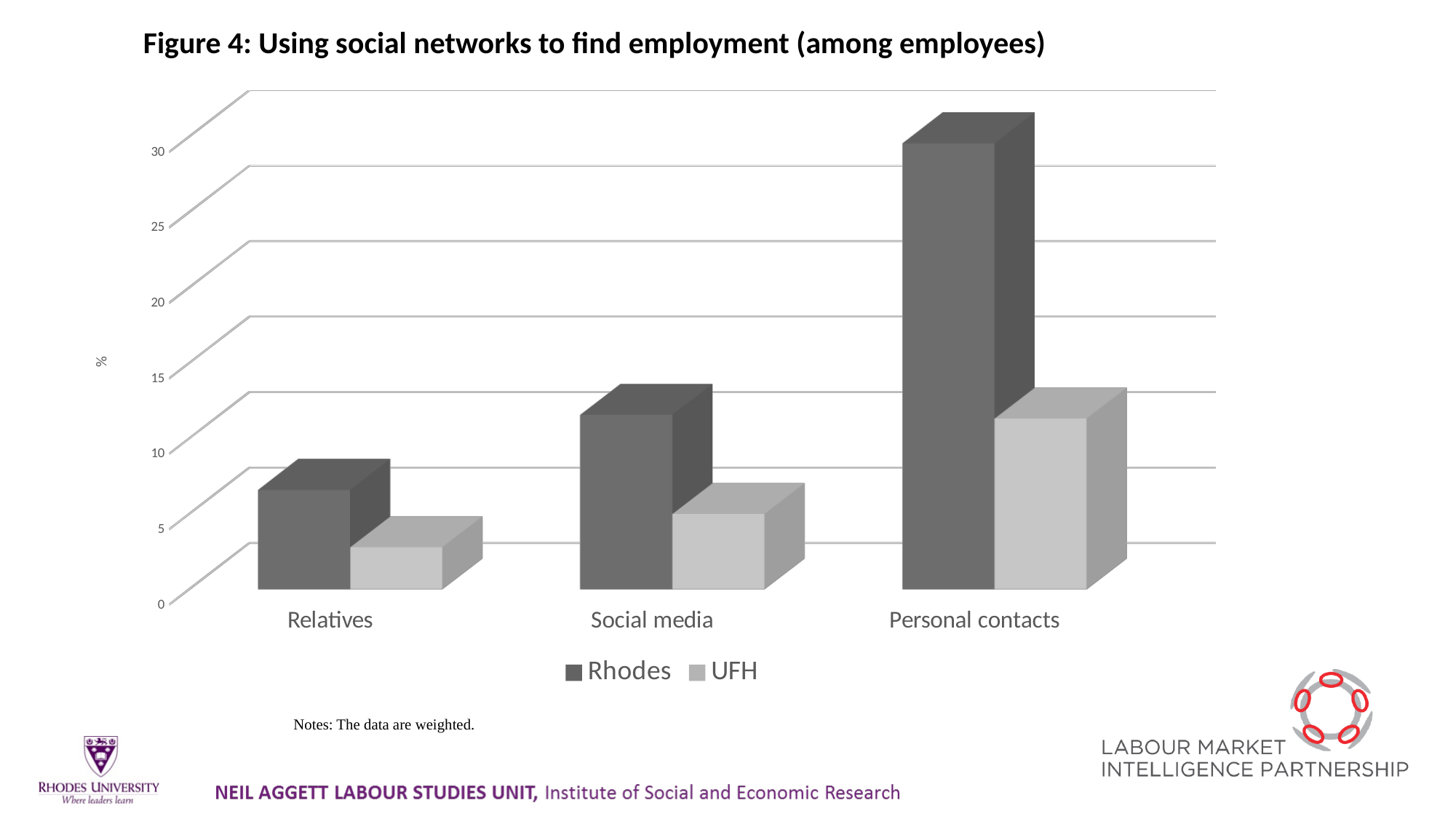
Is the Rhodes value for Social media greater or less than 10? greater Is the Rhodes value for Personal contacts greater or less than 25? greater Which category has the lowest value for UFH? Relatives For Personal contacts, which is larger: the Rhodes value or the UFH value? Rhodes Do the Rhodes values rise or fall moving from Relatives to Personal contacts along the x axis? rise How many categories are shown on the x axis? 3 Which category has the highest value for Rhodes? Personal contacts How many series does the legend list? 2 Is the UFH value for Relatives greater or less than 5? less What is the label on the y axis? % What kind of chart is shown on the slide? Bar chart